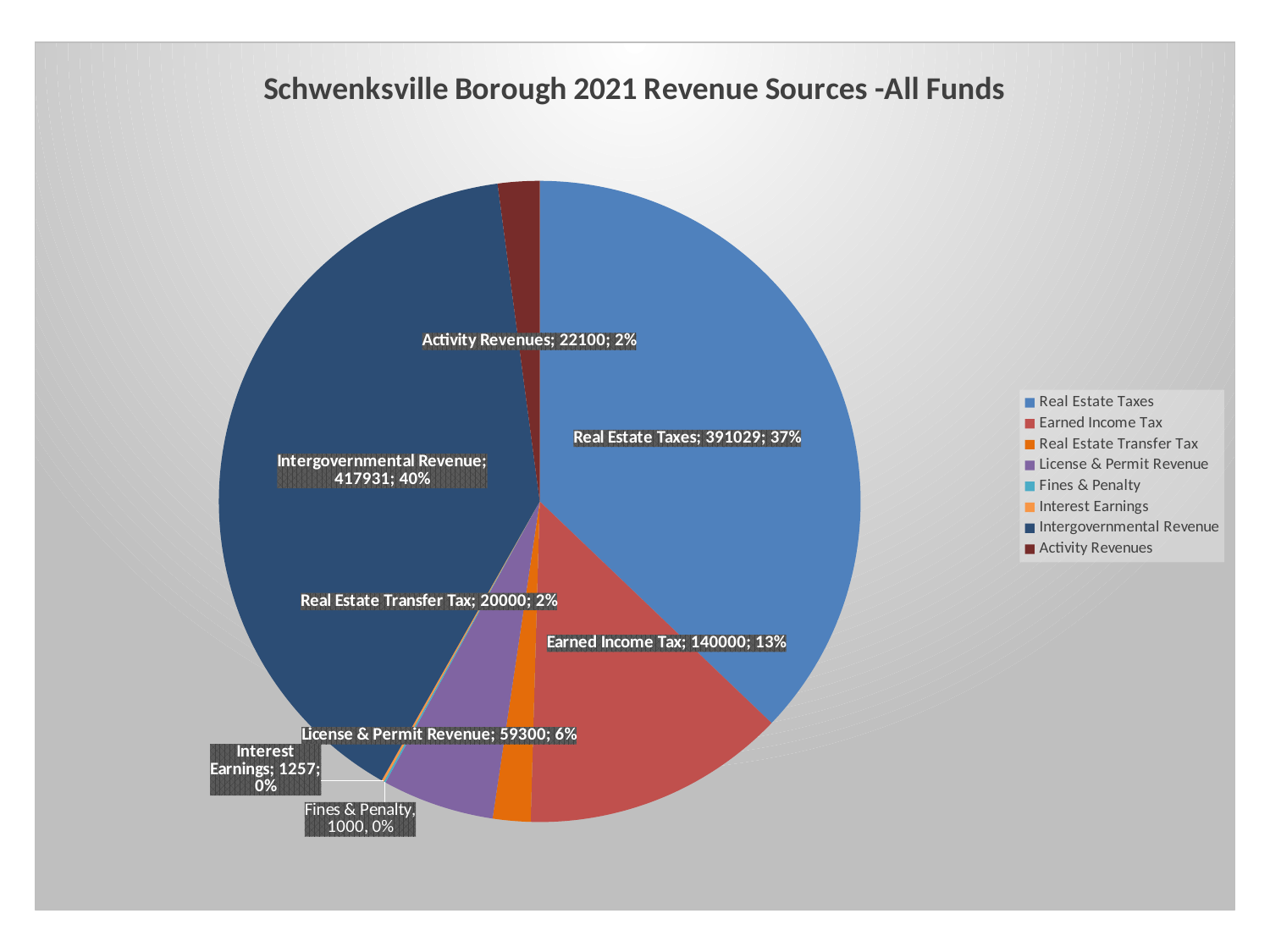
What kind of chart is shown on the slide? Pie chart How many categories does the legend list? 8 What share of the pie does Earned Income Tax represent? 13% What share of the pie does Intergovernmental Revenue represent? 40% Which revenue source has the smallest slice of the pie? Fines & Penalty What is the value for Earned Income Tax? 140000 Which revenue source has the largest slice of the pie? Intergovernmental Revenue Which is larger, Real Estate Transfer Tax or Activity Revenues? Activity Revenues What is the difference between the values for Intergovernmental Revenue and Real Estate Taxes? 26902 What is the value for License & Permit Revenue? 59300 What is the value for Intergovernmental Revenue? 417931 What is the value for Real Estate Taxes? 391029